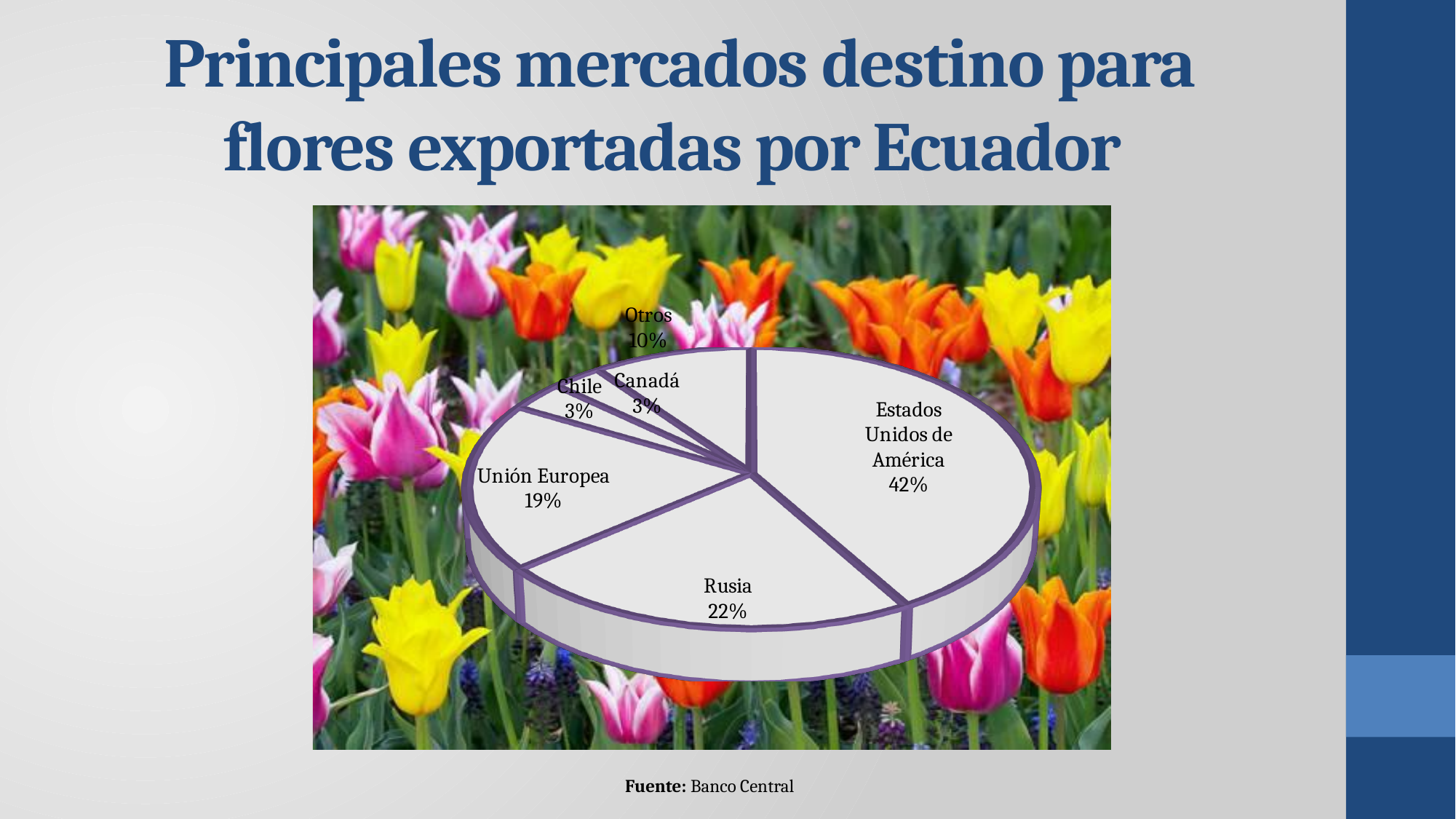
Which is larger, the share for Otros or the share for Chile? Otros What is the value shown for Otros? 10% What is the difference between the shares of Estados Unidos de América and Rusia? 20% What share of the pie does Estados Unidos de América hold? 42% What is the value shown for Canadá? 3% Which category has the largest slice of the pie? Estados Unidos de América What kind of chart is shown on the slide? Pie chart What source is cited below the chart? Banco Central How many slices does the pie chart have? 6 What is the value shown for Rusia? 22% What is the difference between the shares of Rusia and Unión Europea? 3% What is the value shown for Unión Europea? 19%